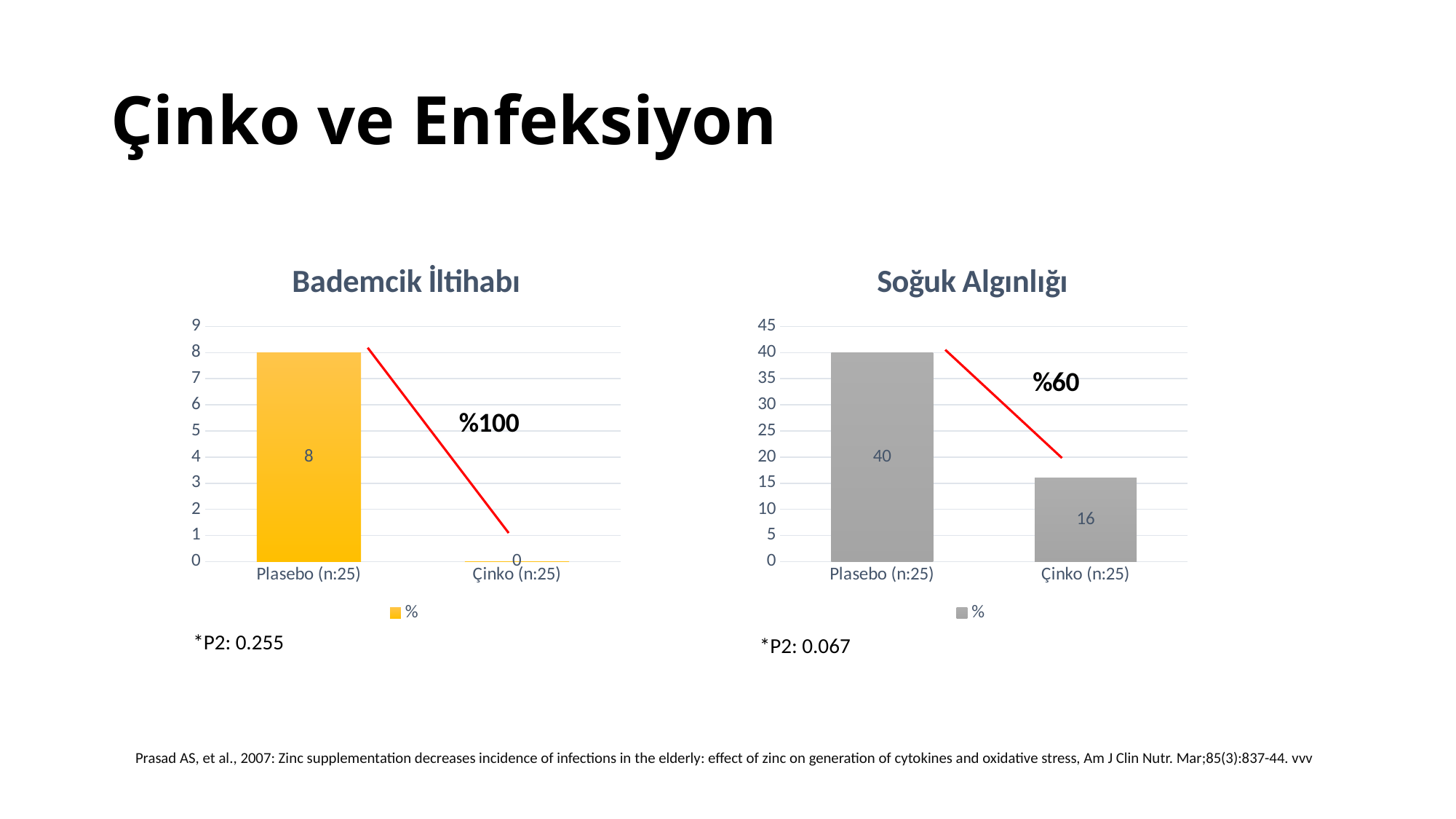
In the 'Bademcik İltihabı' chart, which category has the lowest value? Çinko (n:25) In the 'Soğuk Algınlığı' chart, what is the value for Plasebo (n:25)? 40 What series name does the legend of the 'Soğuk Algınlığı' chart list? % In the 'Soğuk Algınlığı' chart, which category has the highest value? Plasebo (n:25) In the 'Soğuk Algınlığı' chart, what is the difference between the Plasebo (n:25) and Çinko (n:25) values? 24 In the 'Soğuk Algınlığı' chart, what is the value for Çinko (n:25)? 16 In the 'Bademcik İltihabı' chart, what is the difference between the Plasebo (n:25) and Çinko (n:25) values? 8 What type of chart is the 'Bademcik İltihabı' chart? bar chart In the 'Soğuk Algınlığı' chart, is the value for Çinko (n:25) greater or less than 20? less How many categories are shown in the 'Soğuk Algınlığı' chart? 2 In the 'Bademcik İltihabı' chart, what is the value for Çinko (n:25)? 0 In the 'Bademcik İltihabı' chart, what is the value for Plasebo (n:25)? 8